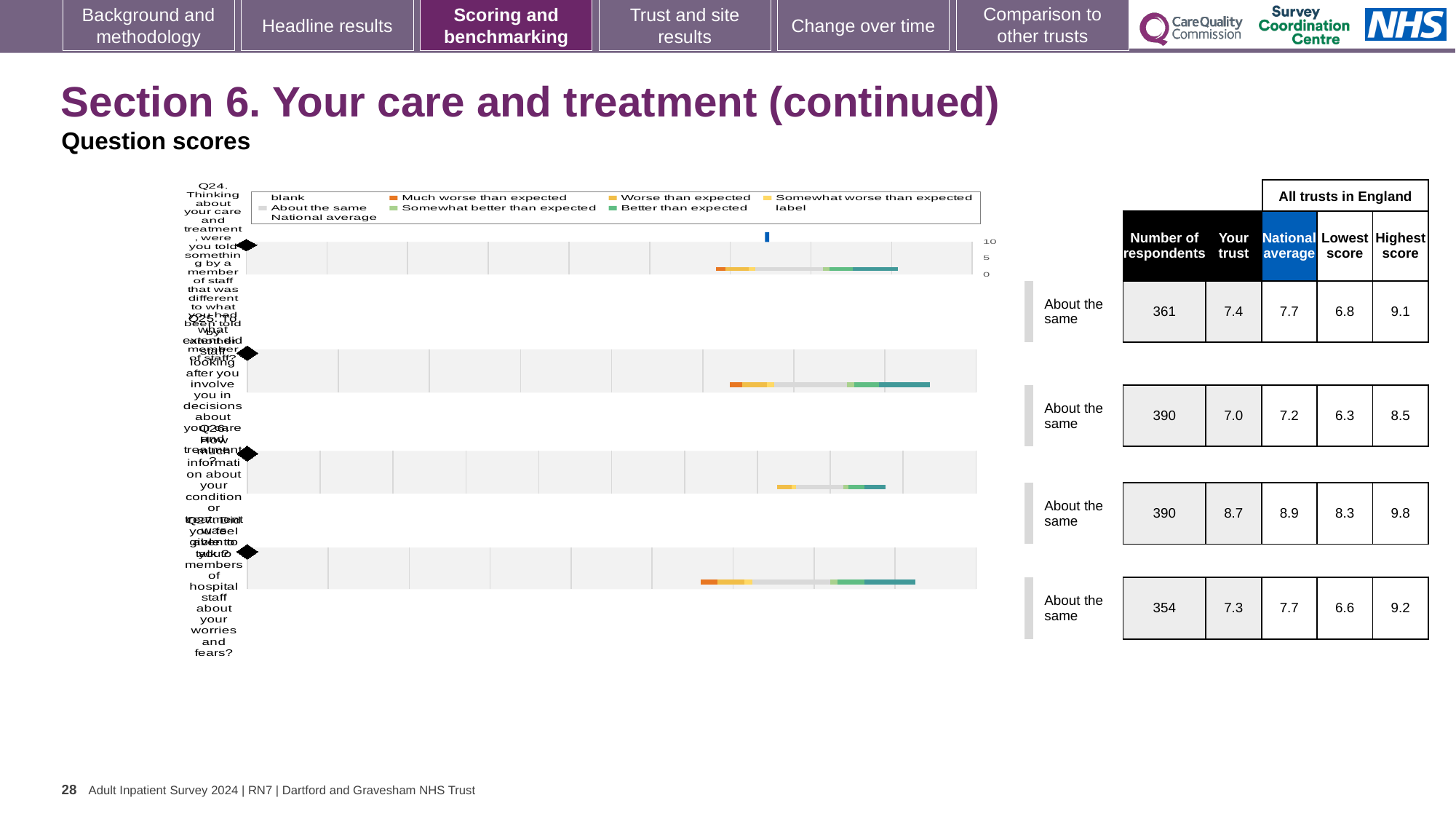
What benchmark category is shown for each of the four questions on the slide? About the same In the table beside the chart, what is the 'Your trust' score for the first question (Q24)? 7.4 In the table beside the chart, what is the national average for the third question (Q26)? 8.9 In the table beside the chart, what is the difference between the highest score and the lowest score for Q26? 1.5 Which legend entry is shown in light grey in the chart? About the same How many questions (categories) are plotted in the chart? 4 In the table beside the chart, which question has the highest 'Your trust' score? Q26 In the table beside the chart, what is the number of respondents for the last question (Q27)? 354 Which legend entry is shown in orange in the chart? Much worse than expected In the table beside the chart, is the 'Your trust' score for Q25 larger or smaller than the national average for Q25? smaller What kind of chart is shown on the slide? bar chart In the table beside the chart, which question has the lowest 'Your trust' score? Q25